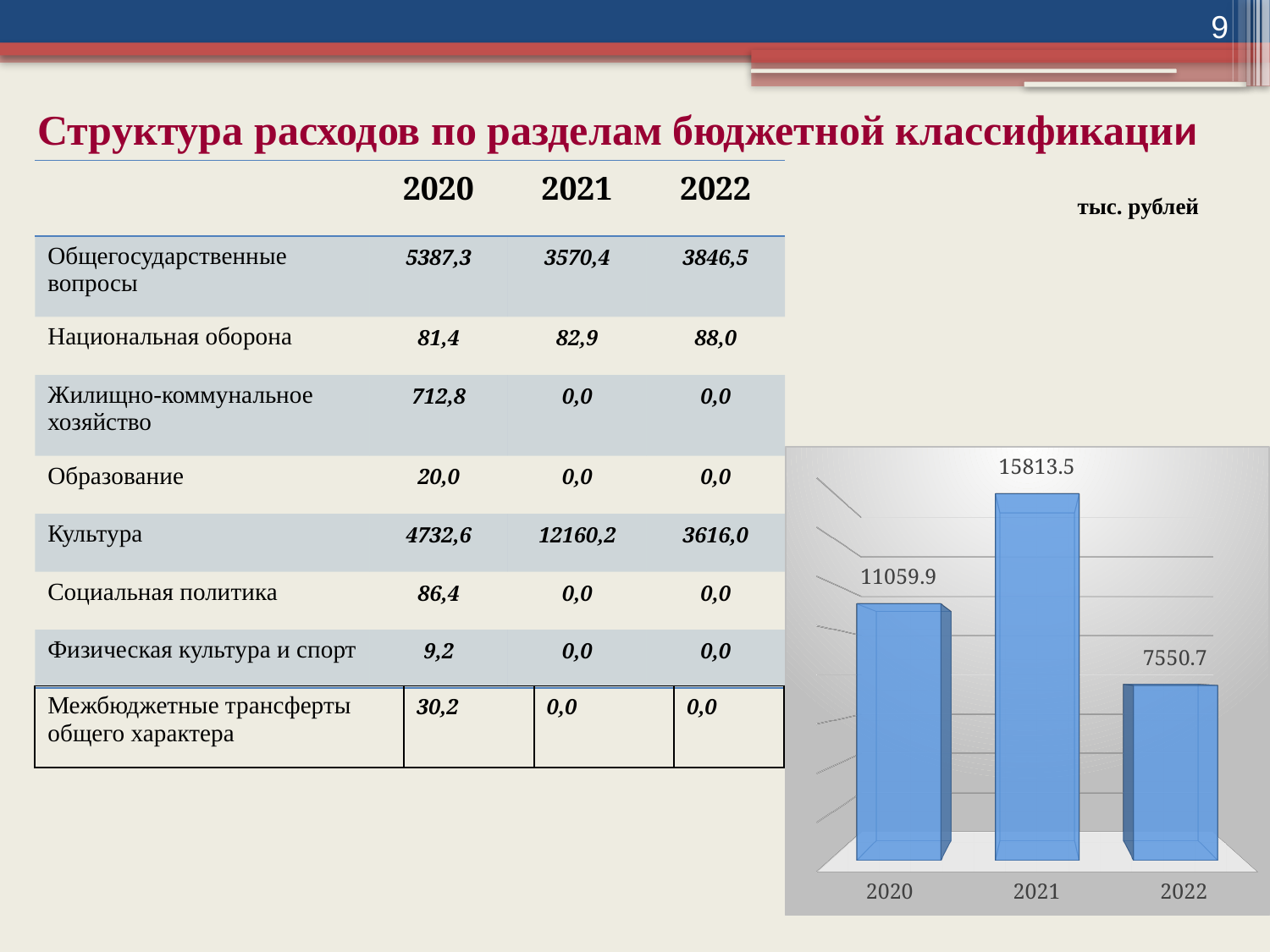
What is the difference between the 2020 and 2022 values in the bar chart? 3509.2 Which is larger in the bar chart, the value for 2020 or the value for 2022? 2020 Which year has the highest value in the bar chart? 2021 Which year has the lowest value in the bar chart? 2022 What is the value shown for 2021 in the bar chart? 15813.5 What is the value shown for 2020 in the bar chart? 11059.9 Do the values in the bar chart rise or fall from 2021 to 2022? fall What is the difference between the 2021 and 2022 values in the bar chart? 8262.8 What is the difference between the 2021 and 2020 values in the bar chart? 4753.6 What is the value shown for 2022 in the bar chart? 7550.7 What type of chart is shown on the slide? bar chart How many bars are shown in the bar chart? 3